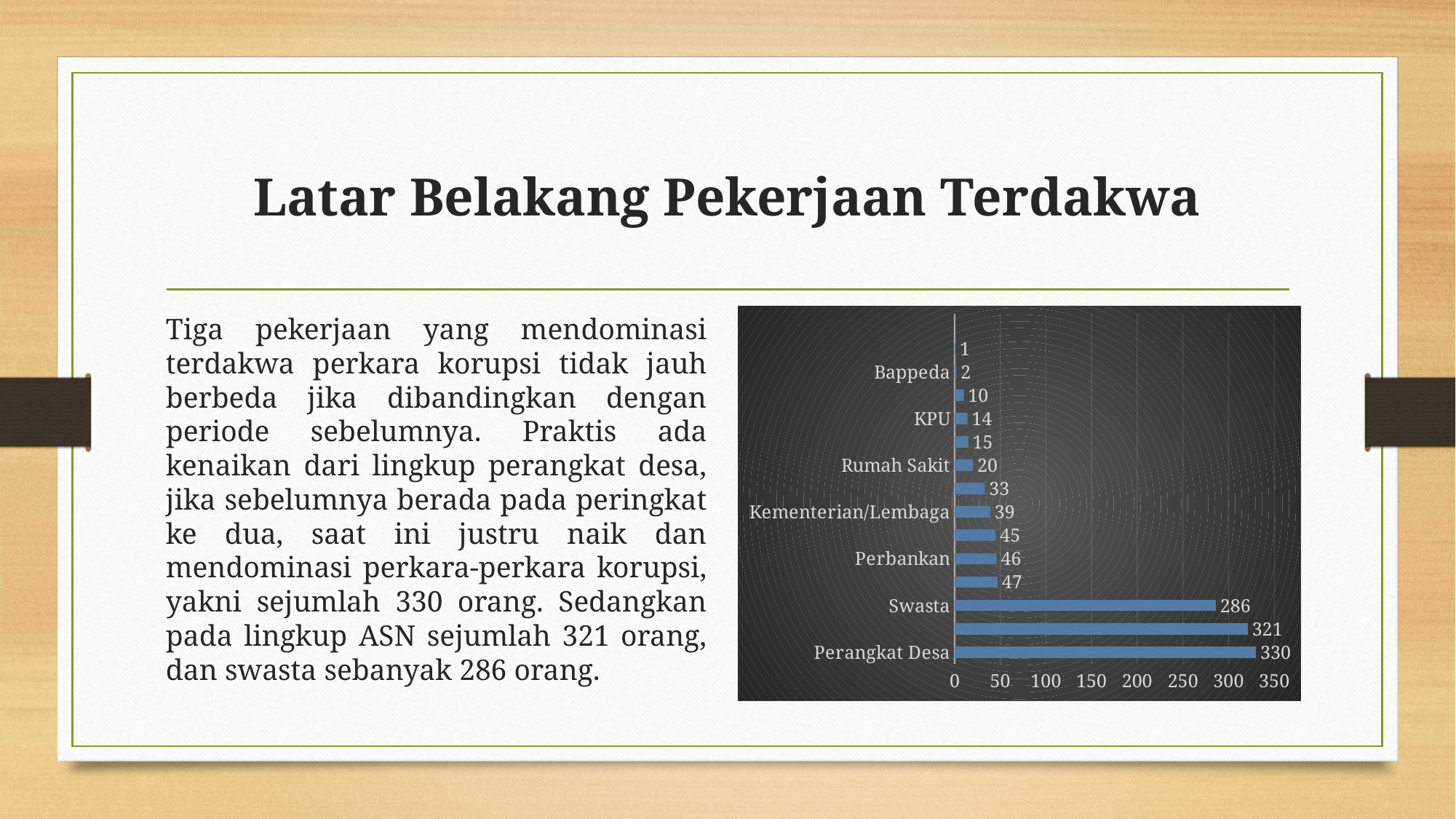
What is the value for KPU? 14 What kind of chart is shown on the slide? Bar chart What is the value for Rumah Sakit? 20 What is the difference between the values for Perangkat Desa and Swasta? 44 What is the value for Bappeda? 2 What is the value for Perbankan? 46 Which is larger, the value for Swasta or the value for Perbankan? Swasta Which category has the highest value? Perangkat Desa What is the value for Perangkat Desa? 330 How many bars are plotted in the chart? 14 What is the value for Kementerian/Lembaga? 39 What is the value for Swasta? 286